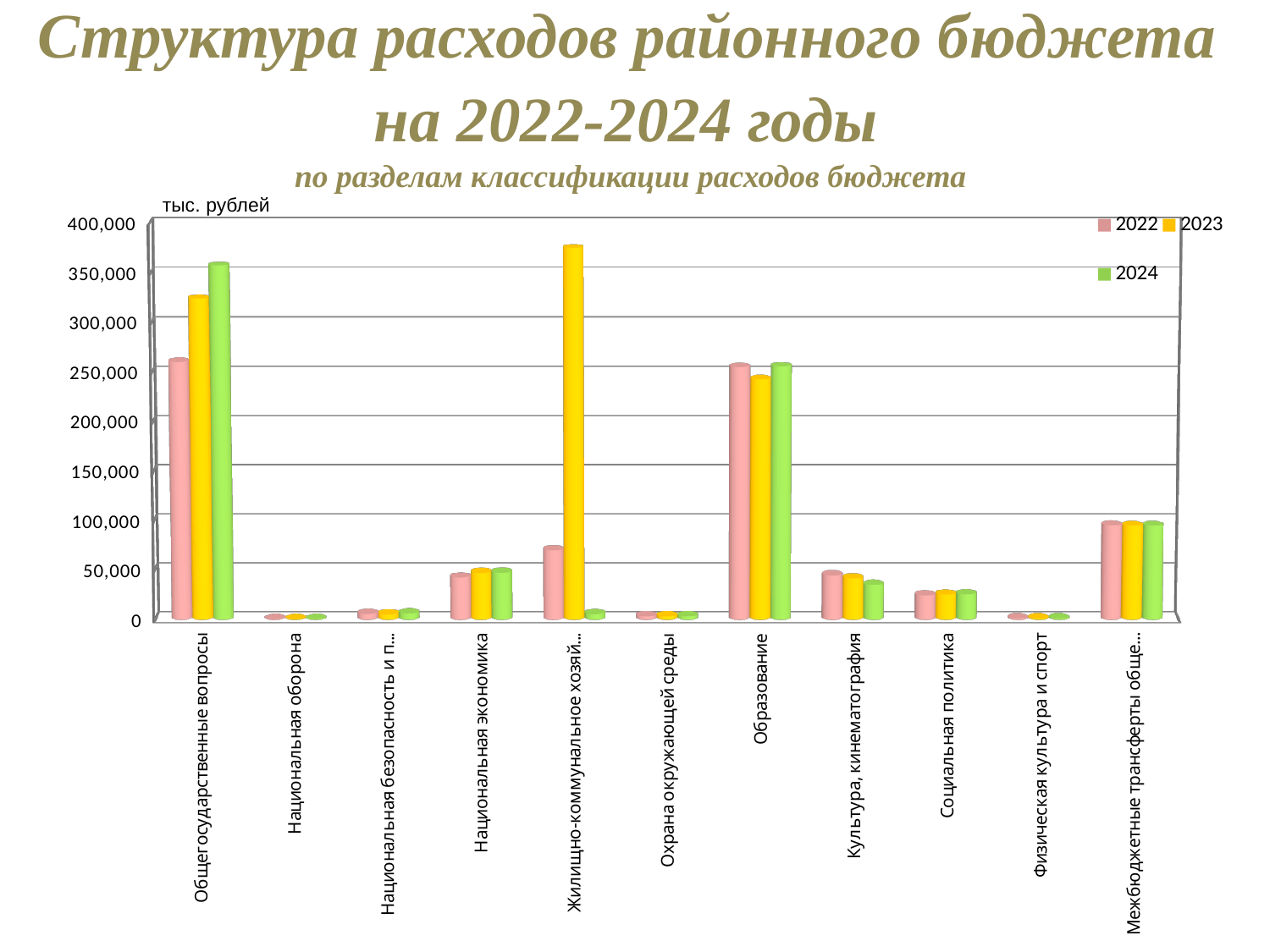
How many expenditure categories are shown along the x axis? 11 Is the 2024 value for Социальная политика greater or less than 50,000? less Is the 2023 value for Жилищно-коммунальное хозяйство greater or less than 350,000? greater Is the 2022 value for Общегосударственные вопросы greater or less than 200,000? greater Do the values for Общегосударственные вопросы rise or fall from 2022 to 2024? rise For 2022, which category has the larger value: Образование or Национальная экономика? Образование Which category has the highest value for 2024? Общегосударственные вопросы How many series does the legend list? 3 What unit is indicated above the vertical axis? тыс. рублей Which category has the highest value for 2023? Жилищно-коммунальное хозяйство For Общегосударственные вопросы, which is larger: the 2022 value or the 2024 value? 2024 What kind of chart is shown on the slide? Bar chart